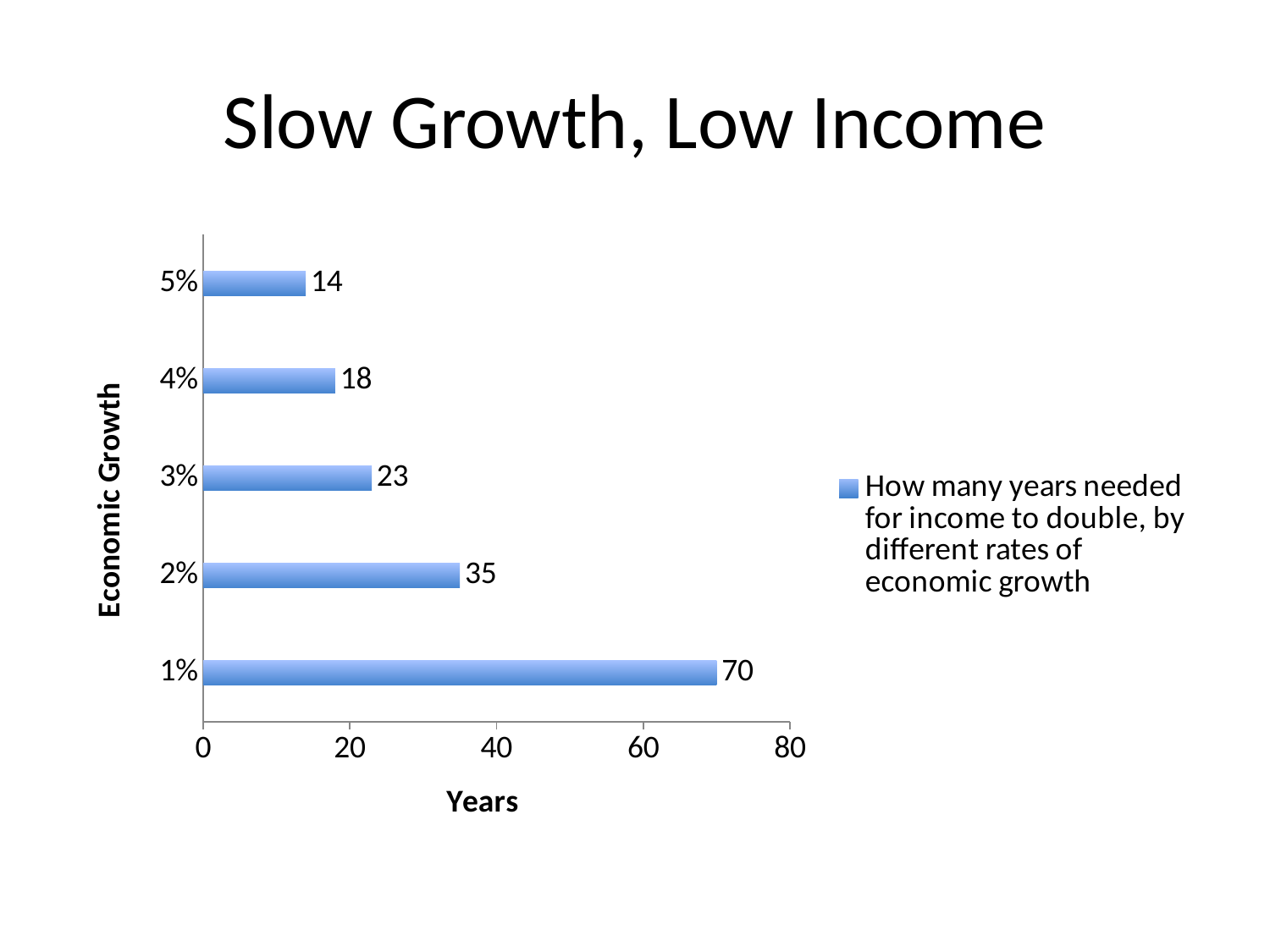
What is the difference in years needed for income to double between 3% and 4% economic growth? 5 What is the label of the horizontal axis of the chart? Years Is the value for 2% economic growth greater or less than 40 years? less How many years are needed for income to double at 3% economic growth? 23 What is the difference in years needed for income to double between 1% and 2% economic growth? 35 How many years are needed for income to double at 5% economic growth? 14 Which economic growth rate requires the fewest years for income to double? 5% What kind of chart is shown on the slide? bar chart How many years are needed for income to double at 1% economic growth? 70 How many economic growth rates are shown on the chart? 5 Which economic growth rate requires the most years for income to double? 1% Which requires more years for income to double: 2% or 4% economic growth? 2%